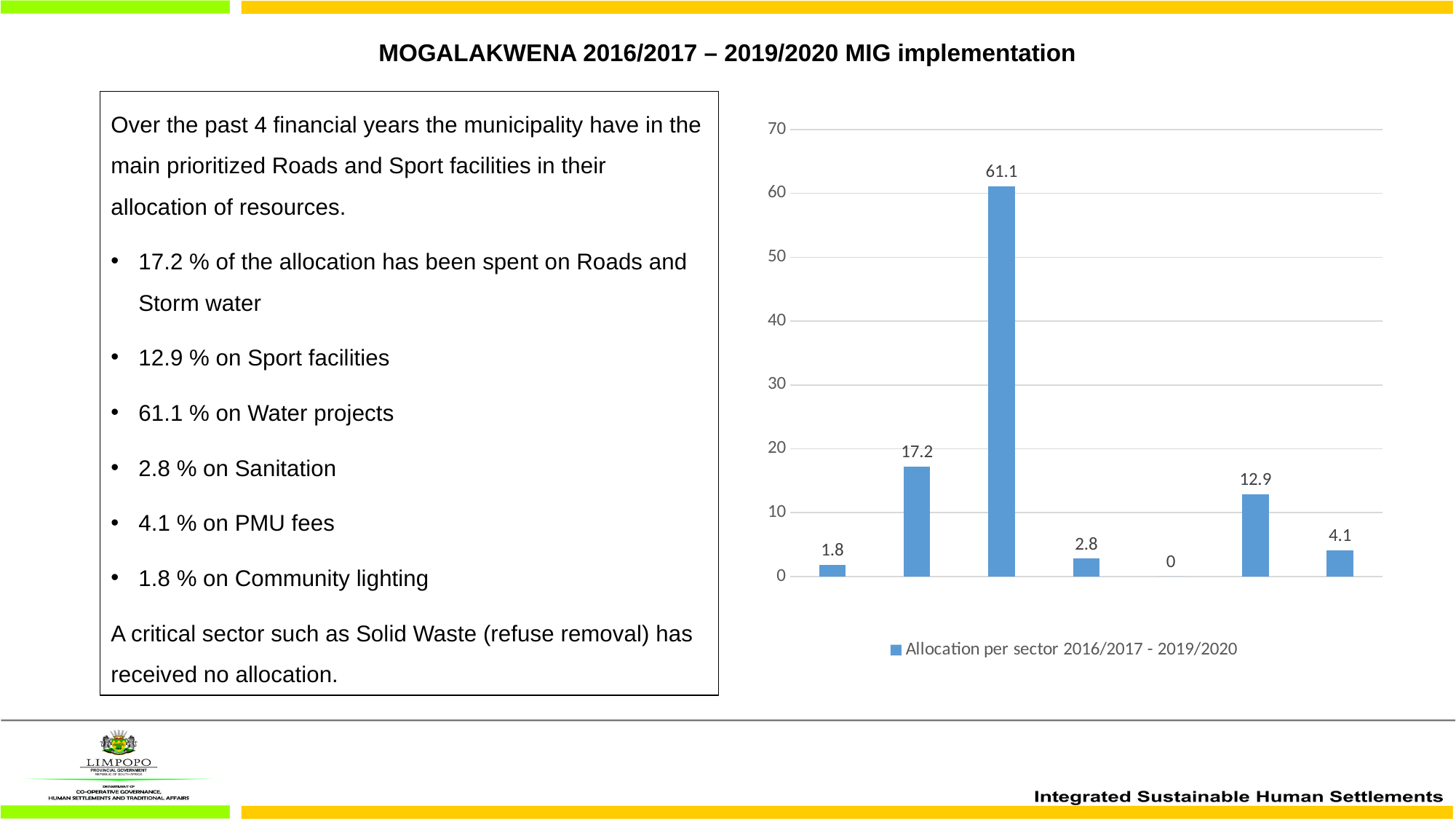
What is the value of the tallest bar in the chart? 61.1 What is the difference between the third bar (61.1) and the second bar (17.2) in the chart? 43.9 How many series does the chart legend list? 1 How many bars are plotted in the chart? 7 What is the value shown on the first bar from the left in the chart? 1.8 What type of chart is shown on the slide? bar chart What is the value of the lowest bar in the chart? 0 Which is larger in the chart, the sixth bar from the left or the fourth bar from the left? the sixth bar (12.9) Is the value of the third bar from the left greater or less than 50? greater What is the legend entry for the series in the chart? Allocation per sector 2016/2017 - 2019/2020 What is the value shown on the second bar from the left in the chart? 17.2 What is the value shown on the last bar on the right in the chart? 4.1